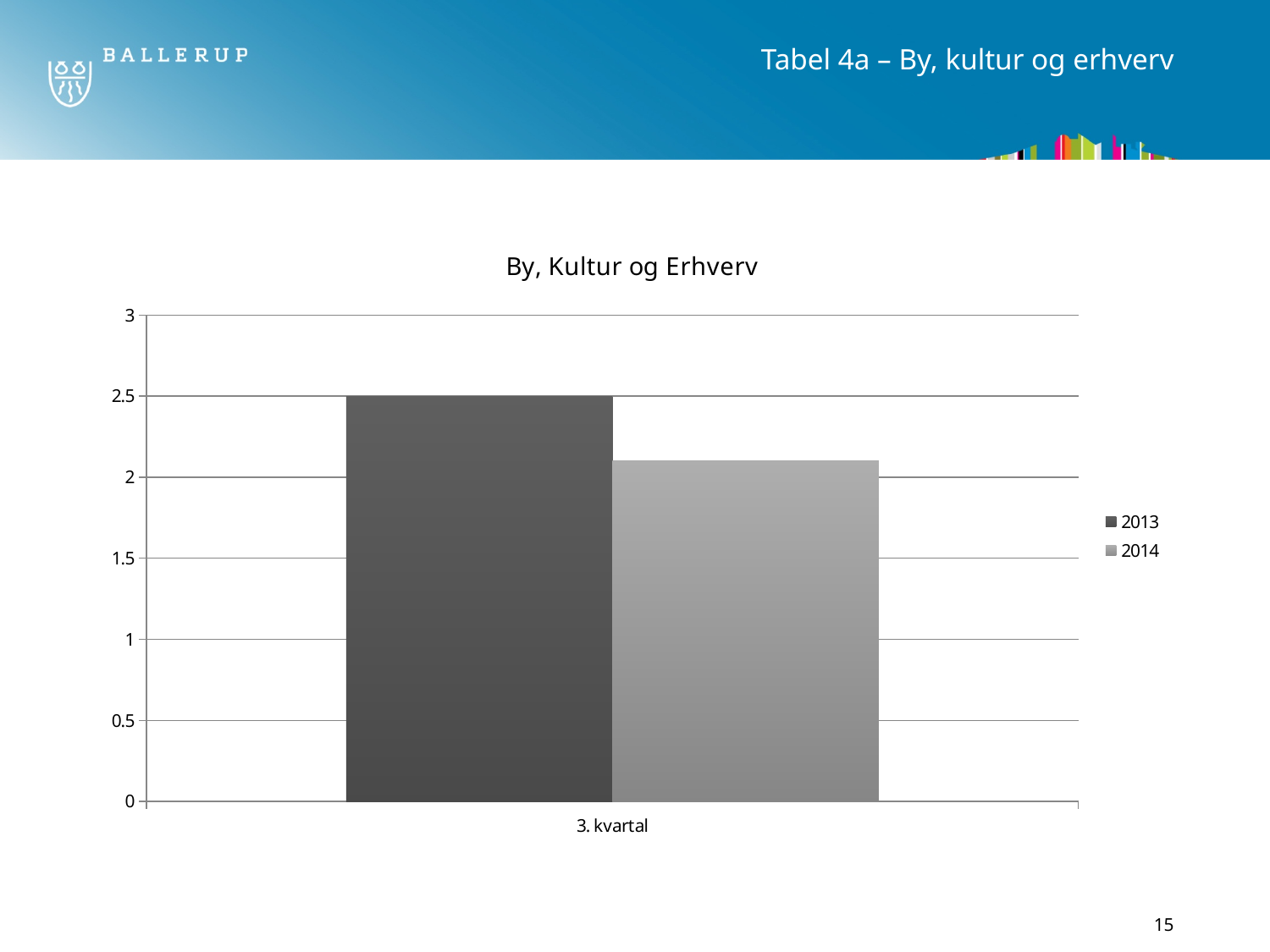
Which series has the lowest bar in the chart? 2014 What are the entries listed in the chart legend? 2013 and 2014 Which series has the highest bar in the chart? 2013 What is the title of the chart? By, Kultur og Erhverv Which series has the larger value for 3. kvartal, 2013 or 2014? 2013 How many series does the legend list? 2 Is the value for 2014 in 3. kvartal greater or less than 2.5? less What kind of chart is shown on the slide? bar chart Is the value for 2014 in 3. kvartal greater or less than 2? greater How many categories are shown on the x axis? 1 What is the value for 2013 in 3. kvartal? 2.5 Is the value for 2013 in 3. kvartal greater or less than 2? greater